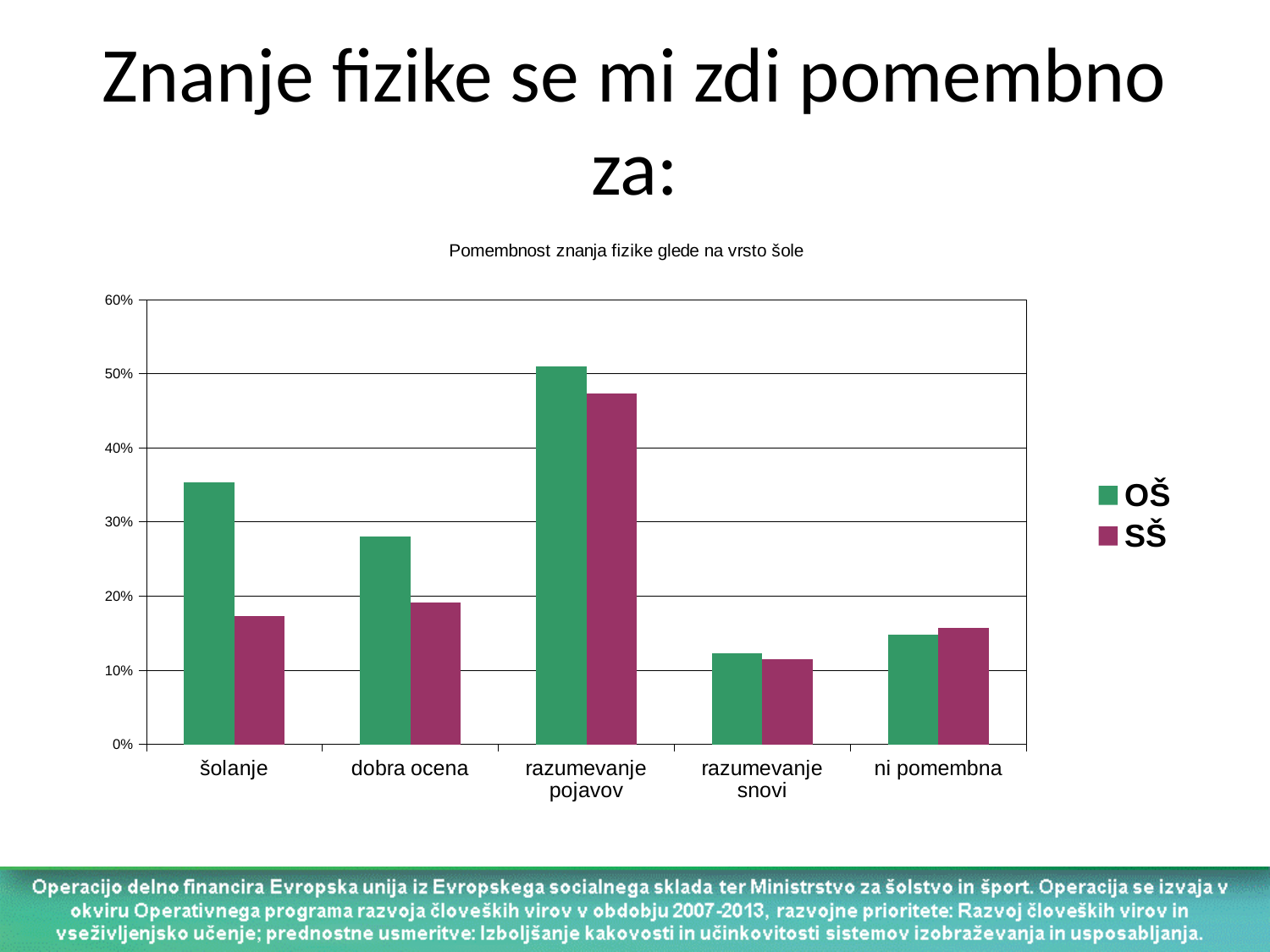
What kind of chart is shown on the slide? bar chart Is the SŠ value for šolanje greater or less than 20%? less Which category has the lowest value for the SŠ series? razumevanje snovi Which category has the highest value for the OŠ series? razumevanje pojavov Which category has the highest value for the SŠ series? razumevanje pojavov How many series does the legend list? 2 Which category has the lowest value for the OŠ series? razumevanje snovi For the category šolanje, which series has the larger value, OŠ or SŠ? OŠ For the category dobra ocena, which series has the larger value, OŠ or SŠ? OŠ How many categories are shown on the x axis of the chart? 5 What is the title of the chart? Pomembnost znanja fizike glede na vrsto šole